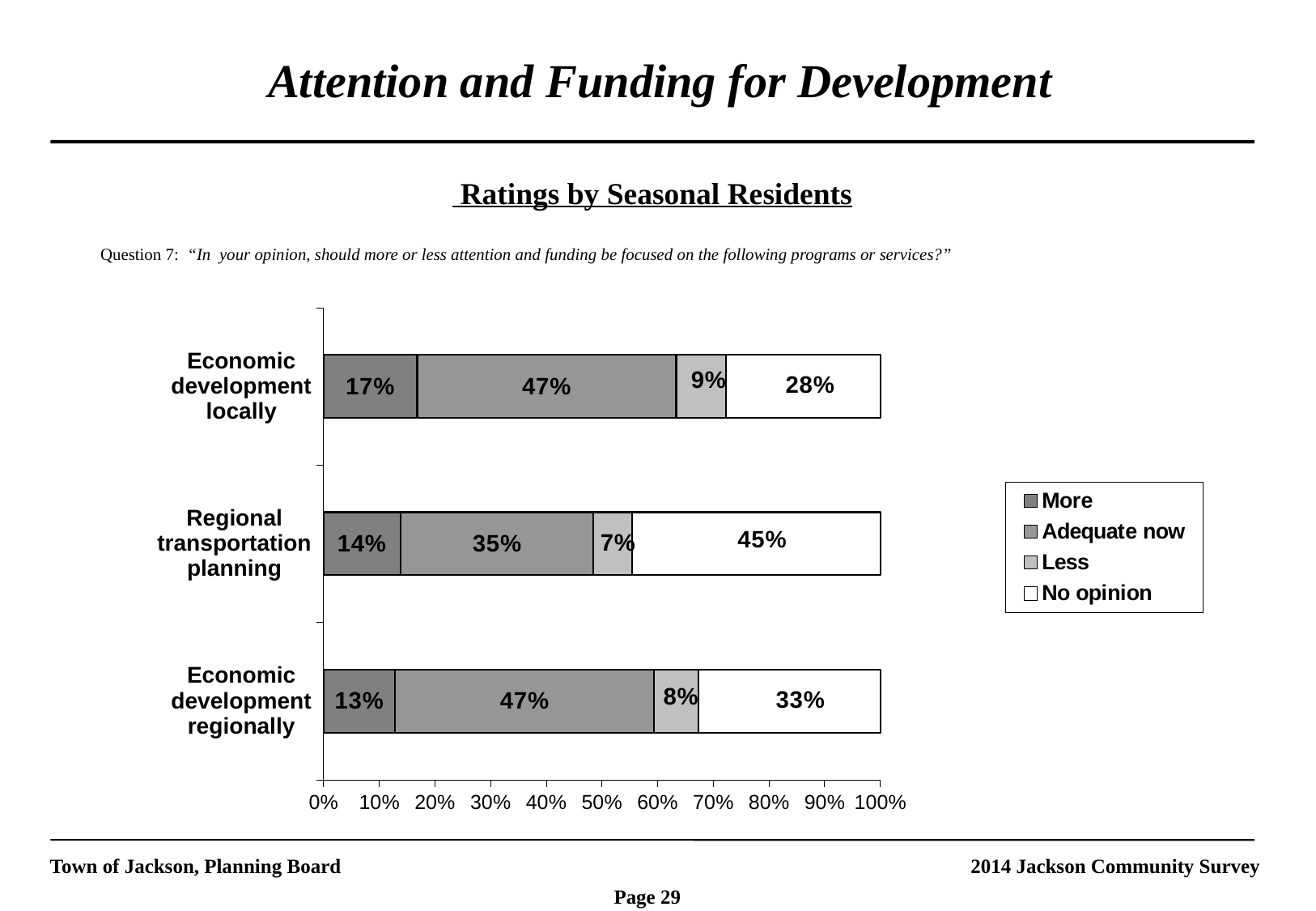
Which category has the lowest "More" share? Economic development regionally Which has a larger "Adequate now" value: Economic development locally or Regional transportation planning? Economic development locally What is the "Adequate now" value for Economic development regionally? 47% How many series does the legend list? 4 What is the difference between the "No opinion" values for Regional transportation planning and Economic development locally? 17 percentage points What percentage of seasonal residents said "More" for Economic development locally? 17% How many categories (programs or services) are shown in the chart? 3 Which category has the highest "No opinion" share? Regional transportation planning Which legend entry is represented by the white segments of the bars? No opinion What kind of chart is shown on the slide? Stacked bar chart What is the "No opinion" value for Regional transportation planning? 45% What is the "Less" value for Regional transportation planning? 7%